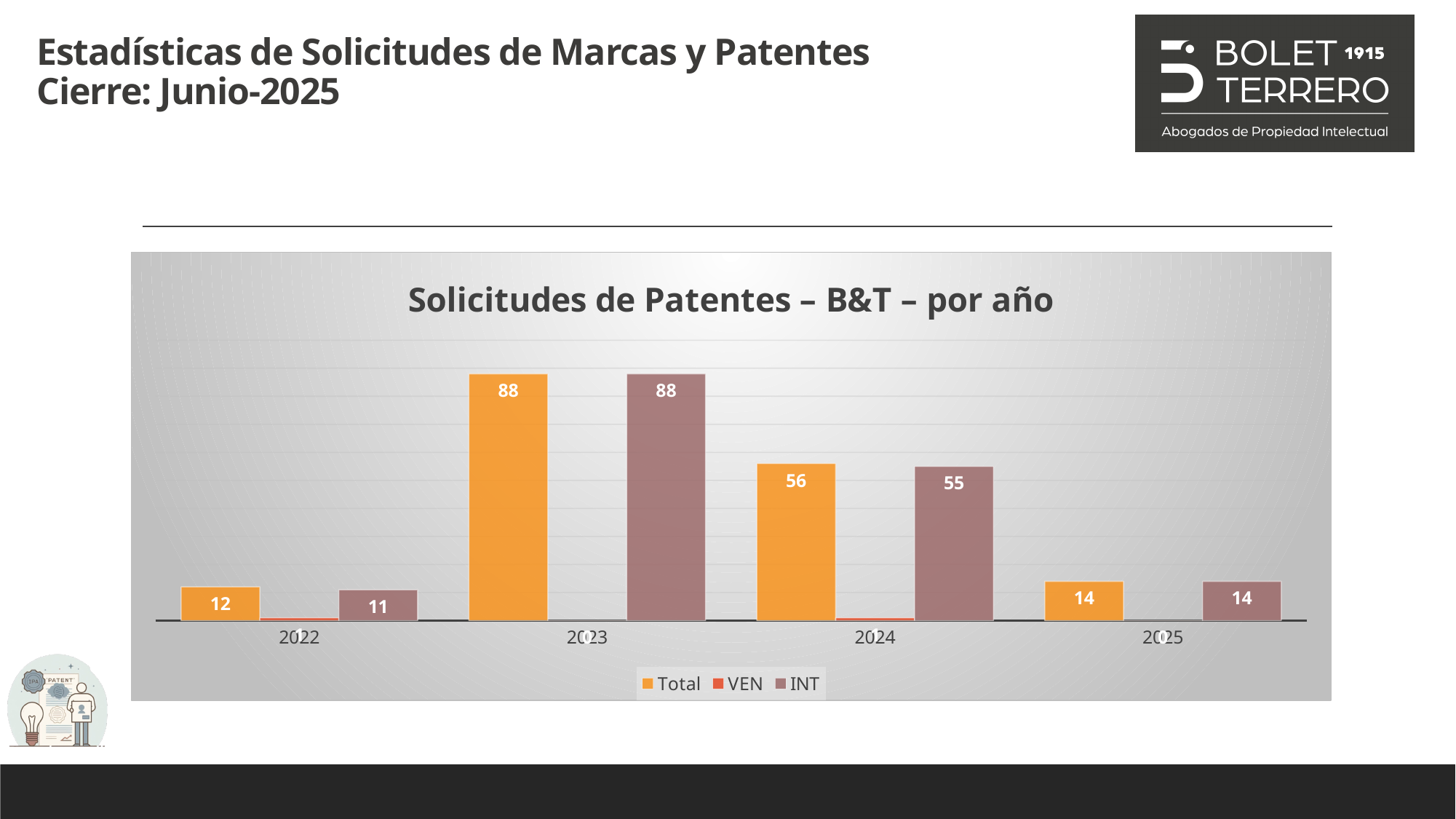
Which year has the lowest INT value? 2022 What is the INT value for 2025? 14 How many years are shown on the x axis? 4 Which year has the highest Total value? 2023 What is the Total value for 2022? 12 What is the Total value for 2023? 88 Which is larger for 2024, the Total value or the INT value? Total What is the INT value for 2024? 55 What is the difference between the Total and INT values for 2022? 1 What is the difference between the Total values for 2023 and 2024? 32 How many series does the legend list? 3 What kind of chart is shown on the slide? Bar chart